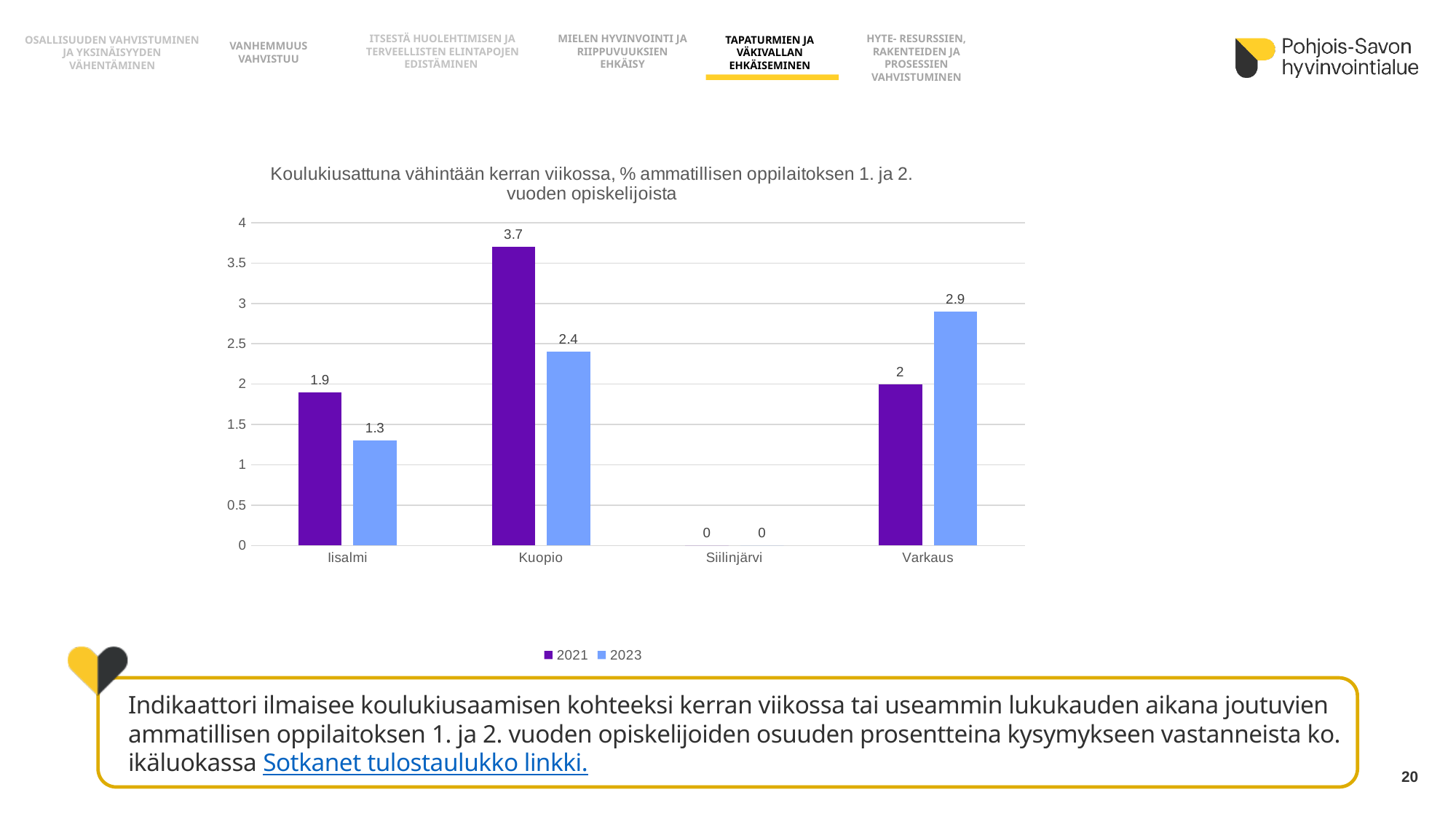
What kind of chart is shown on the slide? bar chart How many categories are shown on the x axis? 4 What is the difference between the 2021 and 2023 values for Kuopio? 1.3 What is the 2021 value for Kuopio? 3.7 Which category has the highest 2021 value? Kuopio Which is larger for Iisalmi, the 2021 value or the 2023 value? 2021 How many series does the legend list? 2 What is the 2023 value for Iisalmi? 1.3 What is the difference between the 2023 and 2021 values for Varkaus? 0.9 Which category has the highest 2023 value? Varkaus What is the 2023 value for Varkaus? 2.9 Which category shows a value of 0 for both 2021 and 2023? Siilinjärvi